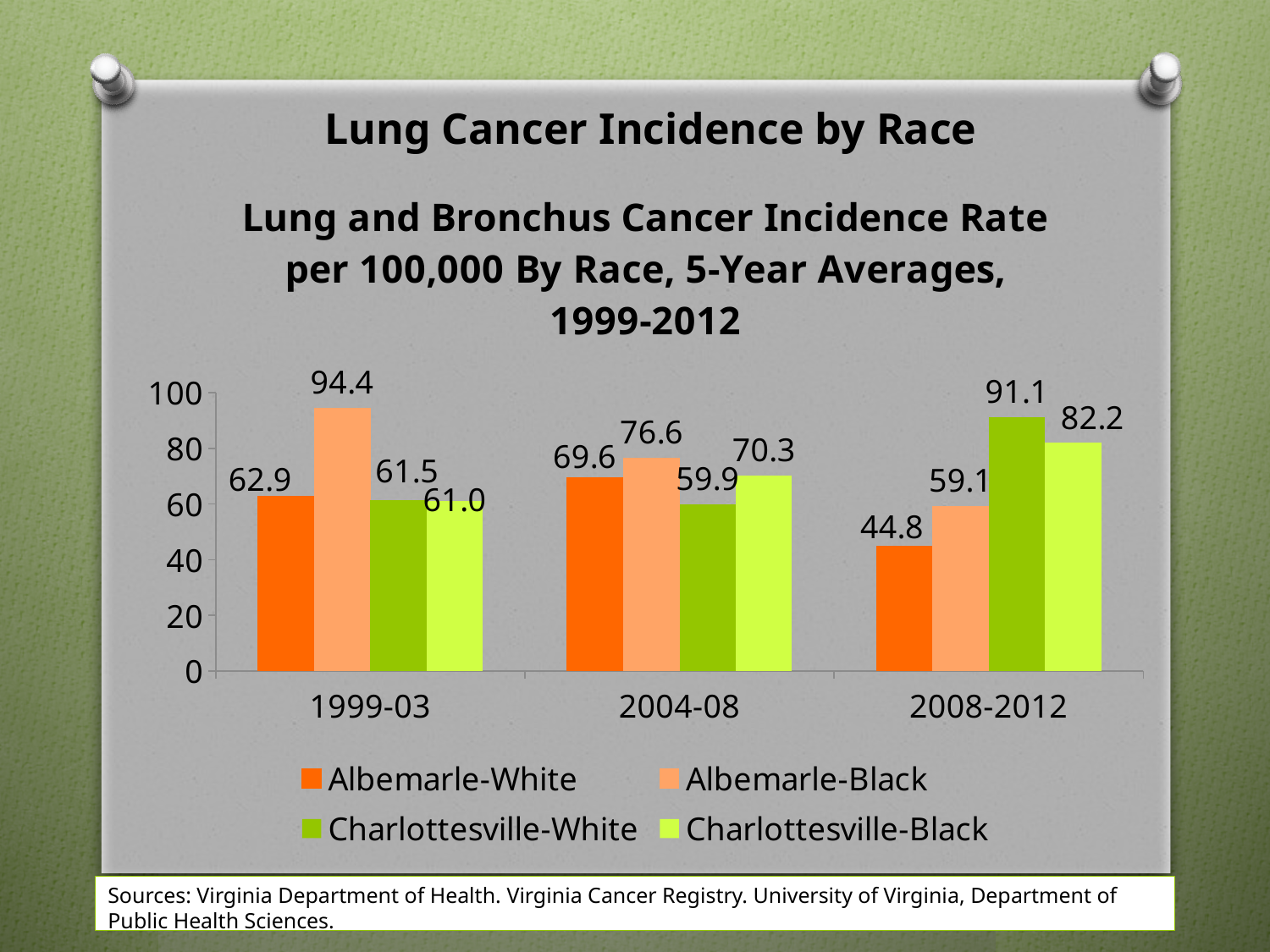
How many series does the legend list? 4 Which series has the highest value in 1999-03? Albemarle-Black How many period categories are shown on the x axis? 3 What is the value for Albemarle-Black in 1999-03? 94.4 What kind of chart is shown on the slide? Bar chart Which is larger in 2004-08, Albemarle-Black or Charlottesville-White? Albemarle-Black Which series has the lowest value in 2008-2012? Albemarle-White Does the value for Albemarle-White rise or fall from 1999-03 to 2008-2012? Fall What is the difference between Charlottesville-White and Albemarle-White in 2008-2012? 46.3 What is the value for Charlottesville-Black in 2004-08? 70.3 What is the value for Charlottesville-White in 2008-2012? 91.1 What is the value for Albemarle-White in 2004-08? 69.6